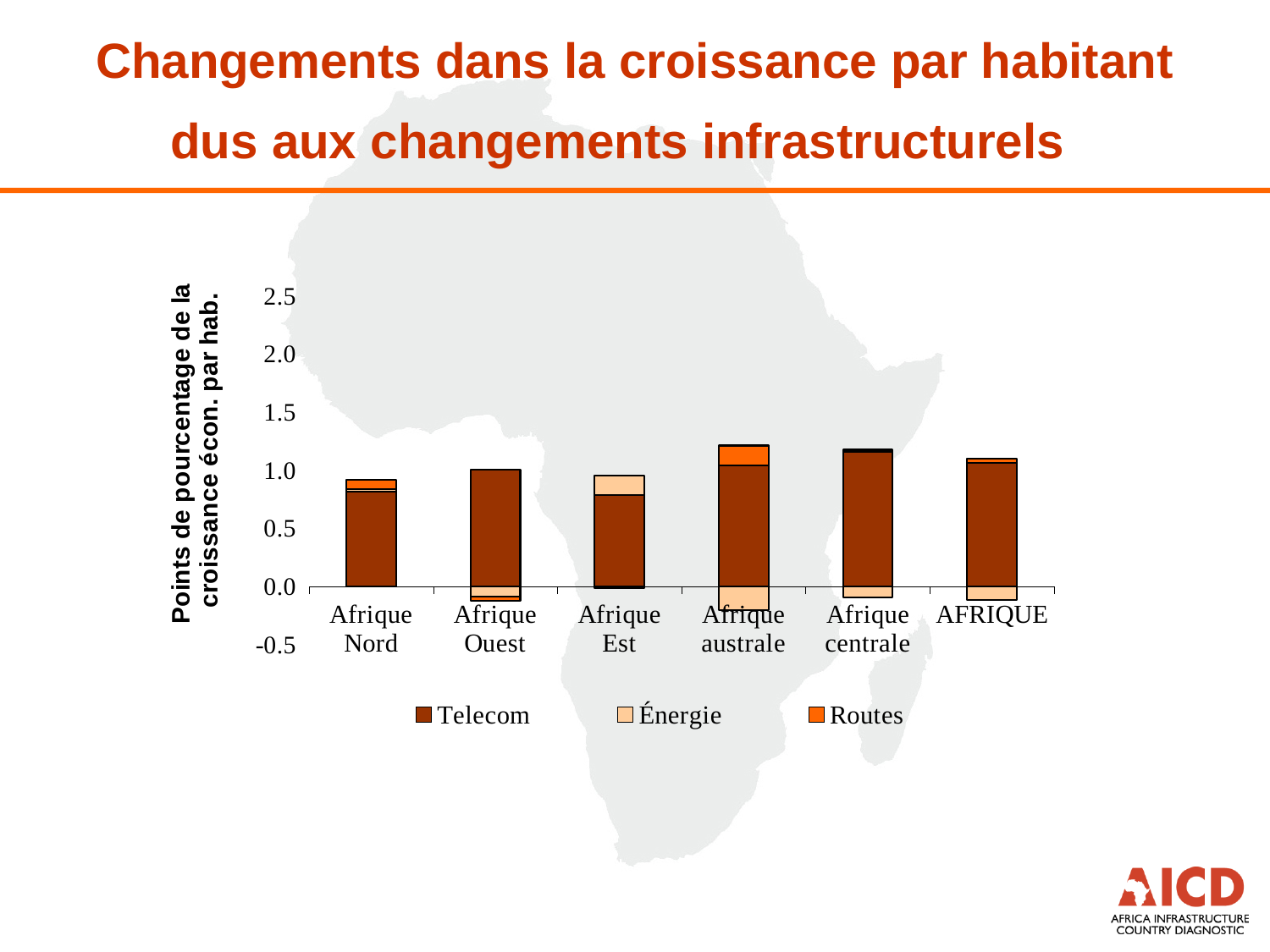
What is the label of the vertical axis of the chart? Points de pourcentage de la croissance écon. par hab. Is the Énergie value for Afrique australe greater or less than 0.0? less Which region has the largest Routes segment in the chart? Afrique australe What kind of chart is shown on the slide? Stacked bar chart Is the Énergie value for Afrique Est greater or less than 0.0? greater Is the Telecom value for Afrique centrale greater or less than 1.0? greater How many series does the chart's legend list? 3 Which region has the largest positive Énergie segment in the chart? Afrique Est How many regions (categories) are shown on the x axis of the chart? 6 What are the three series listed in the chart's legend? Telecom, Énergie, Routes